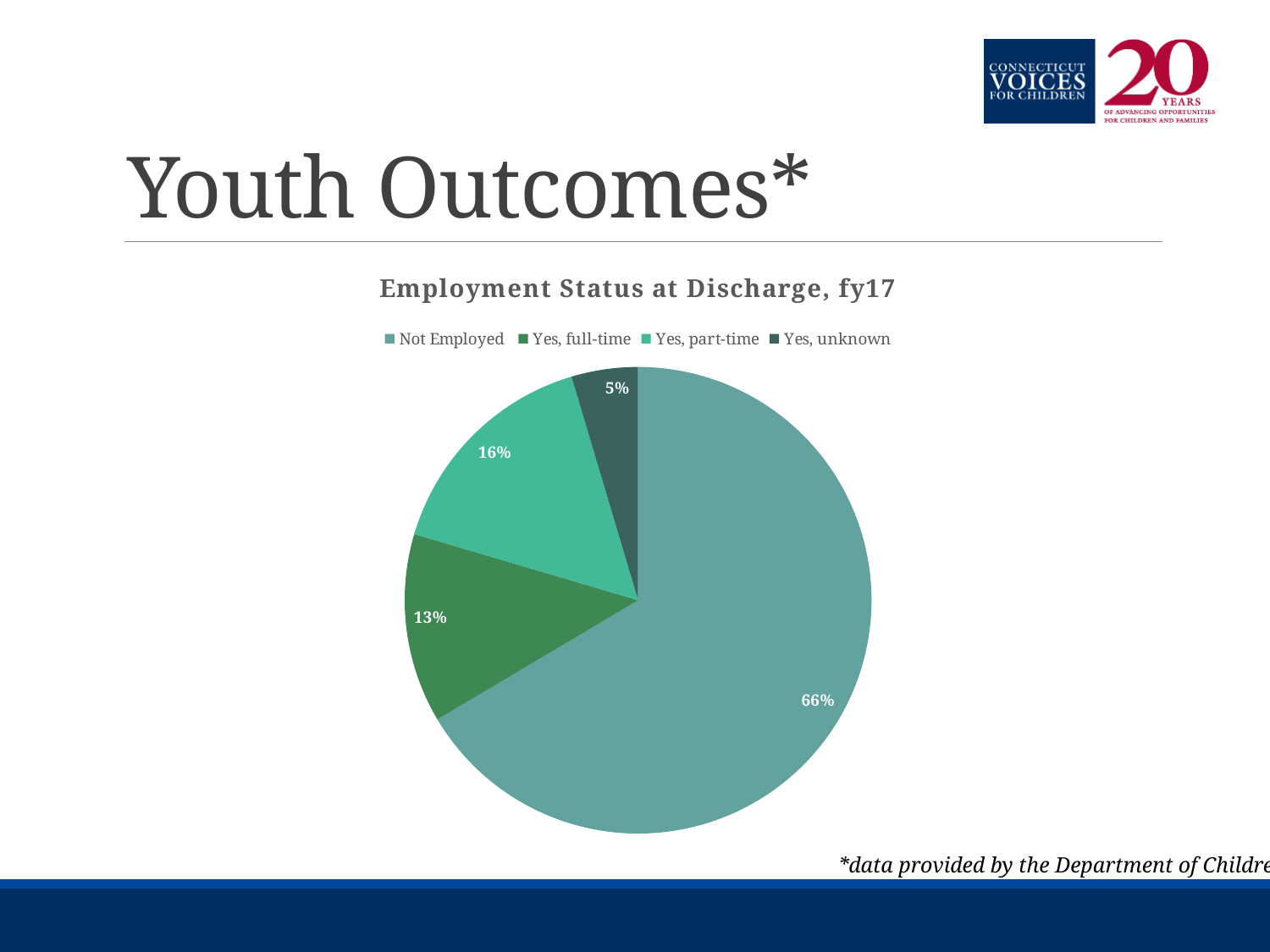
What percentage of youth were employed full-time at discharge? 13% Which category has the smallest share of the pie? Yes, unknown What is the difference in percentage points between the Not Employed slice and the Yes, part-time slice? 50 How many categories does the pie chart show? 4 What share of the pie is labelled Not Employed? 66% What percentage is shown for the 'Yes, unknown' slice? 5% Which category has the largest share of the pie? Not Employed What is the title of the chart? Employment Status at Discharge, fy17 Which is larger, the Yes, full-time slice or the Yes, part-time slice? Yes, part-time What percentage of youth were employed part-time at discharge? 16% How many entries does the legend list? 4 What type of chart is shown on the slide? Pie chart